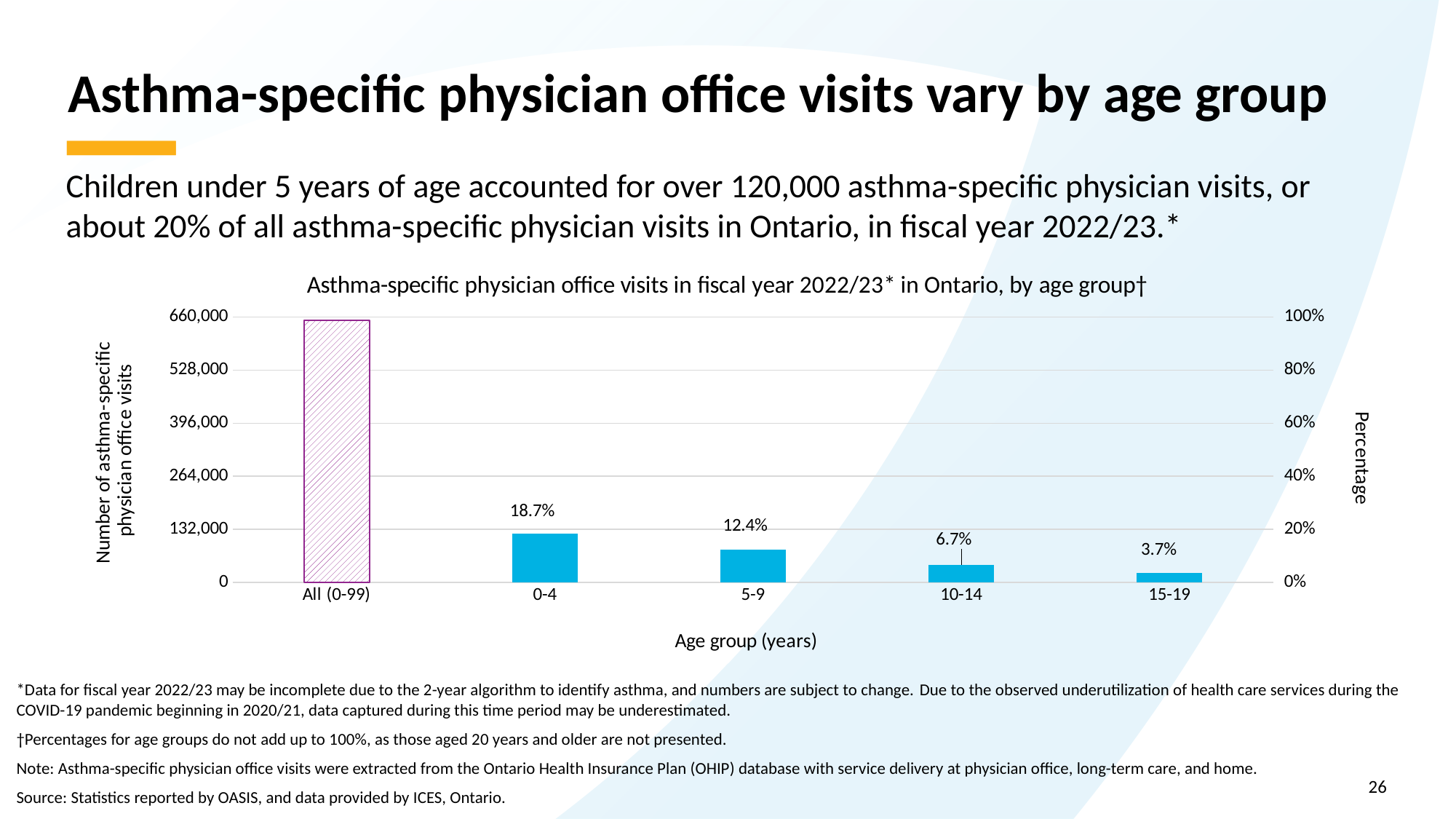
Do the percentages rise or fall moving from the 0-4 age group to the 15-19 age group? Fall What is the difference in percentage points between the 0-4 and 5-9 age groups? 6.3 percentage points Which category has the tallest bar in the chart? All (0-99) What percentage is shown for the 10-14 age group? 6.7% Is the number of visits for All (0-99) greater or less than 528,000? greater How many categories are shown on the x axis of the chart? 5 What kind of chart is shown on the slide? Bar chart What percentage is shown for the 15-19 age group? 3.7% Which has a larger share of visits, the 5-9 age group or the 10-14 age group? 5-9 What percentage of asthma-specific physician office visits is shown for the 0-4 age group? 18.7% What percentage is shown for the 5-9 age group? 12.4% Among the individual age groups (0-4, 5-9, 10-14, 15-19), which has the lowest percentage? 15-19